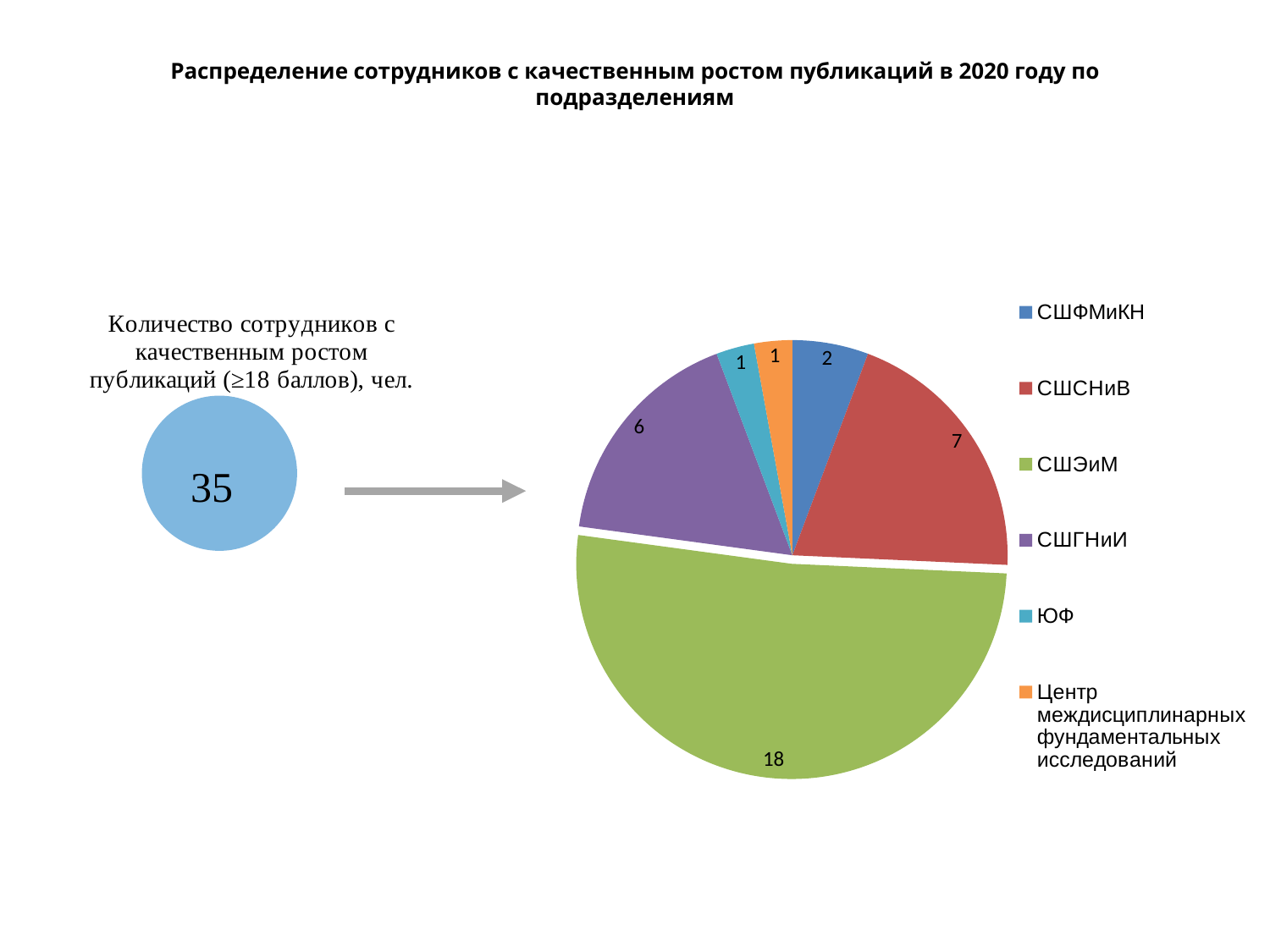
How many slices does the pie chart have? 6 What is the value for СШФМиКН in the pie chart? 2 Which is larger, the value for СШГНиИ or the value for СШФМиКН? СШГНиИ What is the value for СШСНиВ in the pie chart? 7 What kind of chart is shown on the slide? pie chart What is the difference between the values for СШЭиМ and СШСНиВ? 11 What is the value for СШГНиИ in the pie chart? 6 What is the value for ЮФ in the pie chart? 1 What share of the pie does СШСНиВ represent? 20% What is the value for СШЭиМ in the pie chart? 18 What is the total number of employees shown in the blue circle on the left of the slide? 35 Which category has the largest slice in the pie chart? СШЭиМ